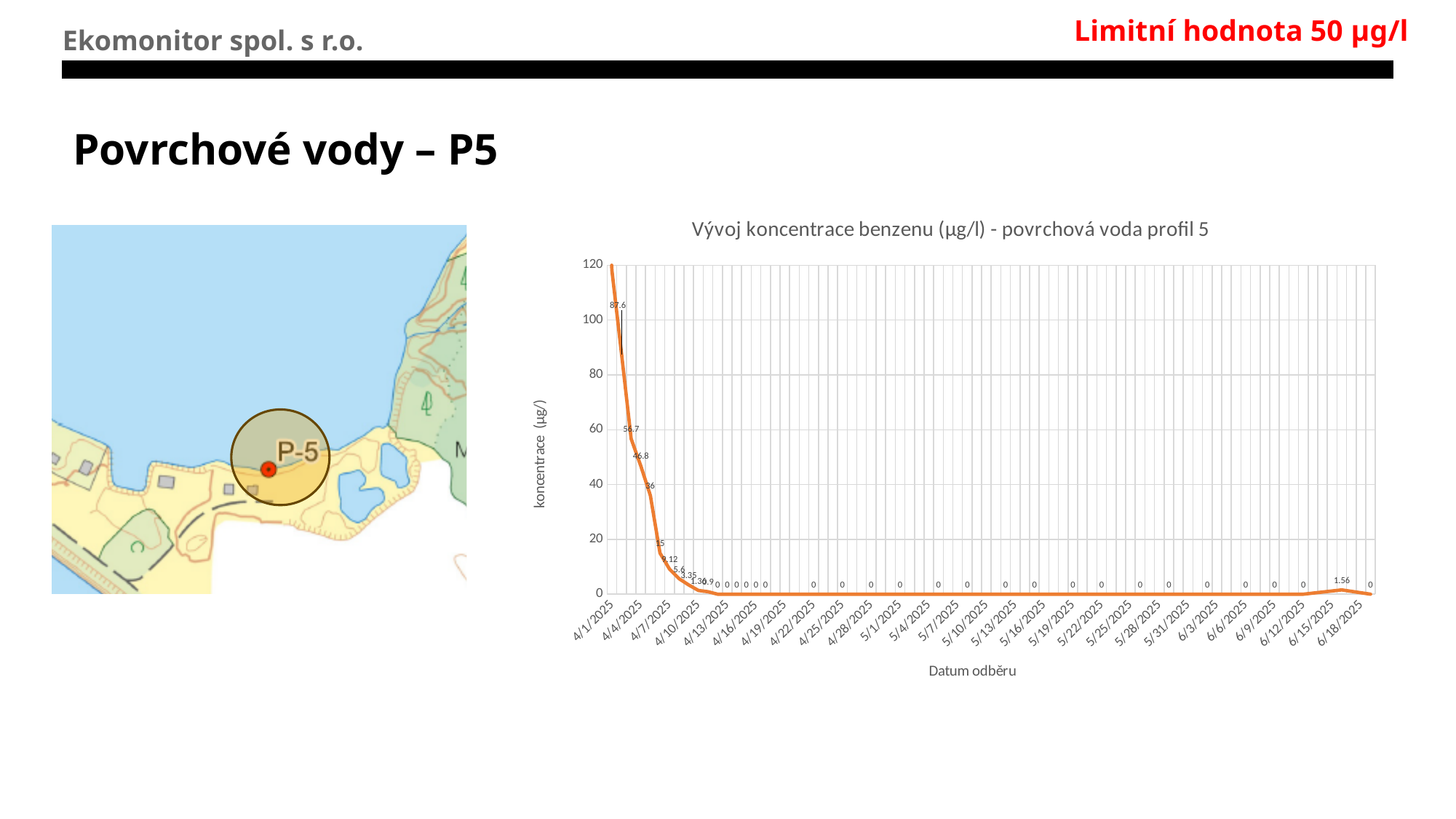
Is the concentration value at 4/1/2025 greater or less than 100? greater Which data label immediately follows 46.8 along the line? 36 What is the title of the y axis? koncentrace (µg/l) What is the data label for the last point, at 6/18/2025? 0 What is the data label on the small bump in the line shortly before 6/18/2025? 1.56 Is the concentration value at 5/1/2025 greater or less than 20? less What kind of chart is shown on the slide? line chart Do the benzene concentration values rise or fall along the x axis from 4/1/2025 onward? fall What is the highest value shown on the y axis? 120 Which date has the larger concentration value, 4/1/2025 or 6/18/2025? 4/1/2025 Which data label immediately follows 87.6 along the line? 56.7